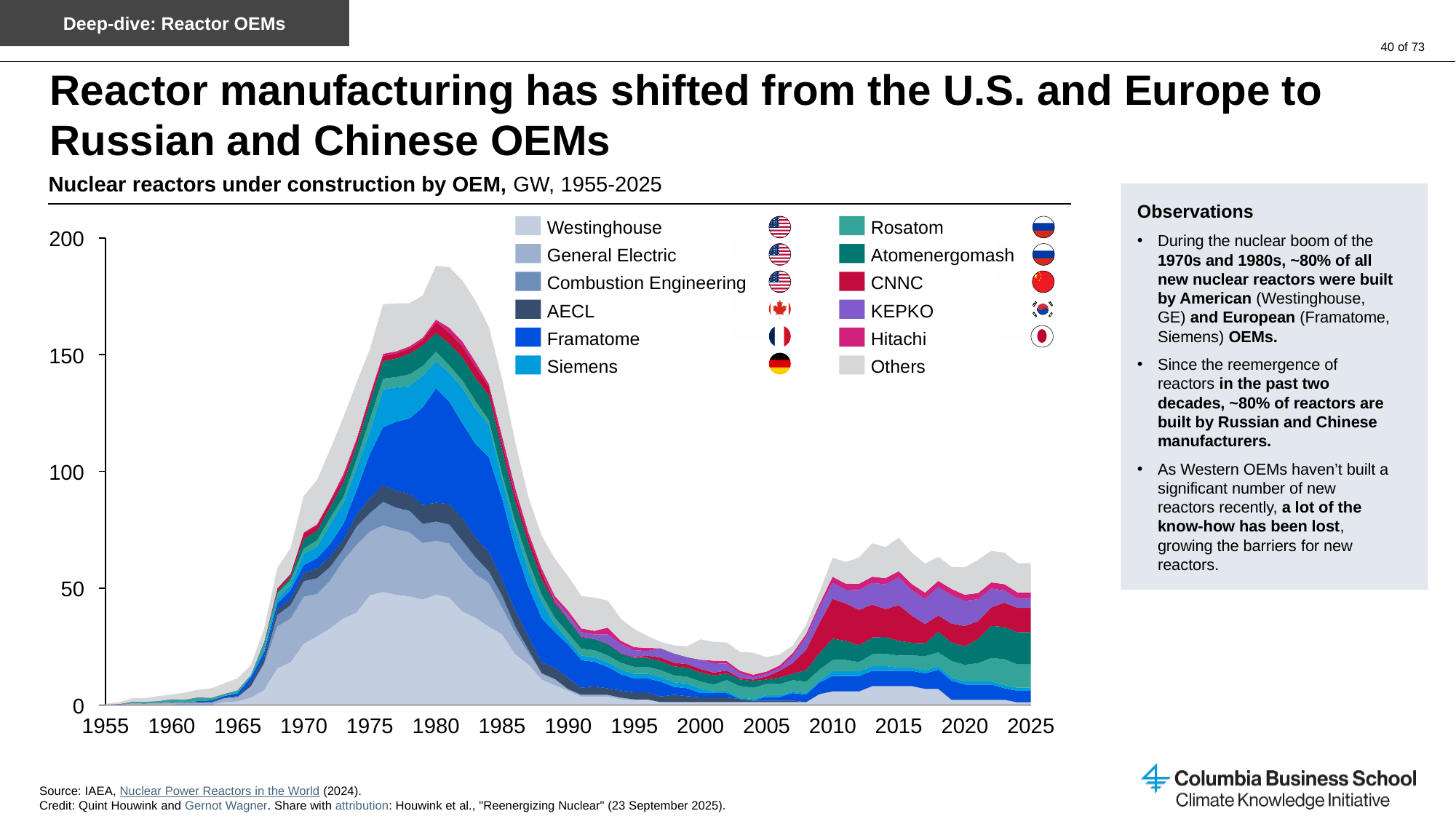
How many year labels are shown on the x axis? 15 Is the total value of reactors under construction around 1980 greater or less than 150? greater Which legend entry is shown with the Canadian flag? AECL Does the total value rise or fall between 1980 and 2000? fall Is the total value of reactors under construction in 2015 greater or less than 100? less Is the total value of reactors under construction in 2000 greater or less than 50? less Around which year labeled on the x axis does the total reach its highest point? 1980 Does the total value rise or fall between 1965 and 1980? rise What is the title of the chart? Nuclear reactors under construction by OEM, GW, 1955-2025 How many series does the legend list? 12 What kind of chart is shown on the slide? Stacked area chart